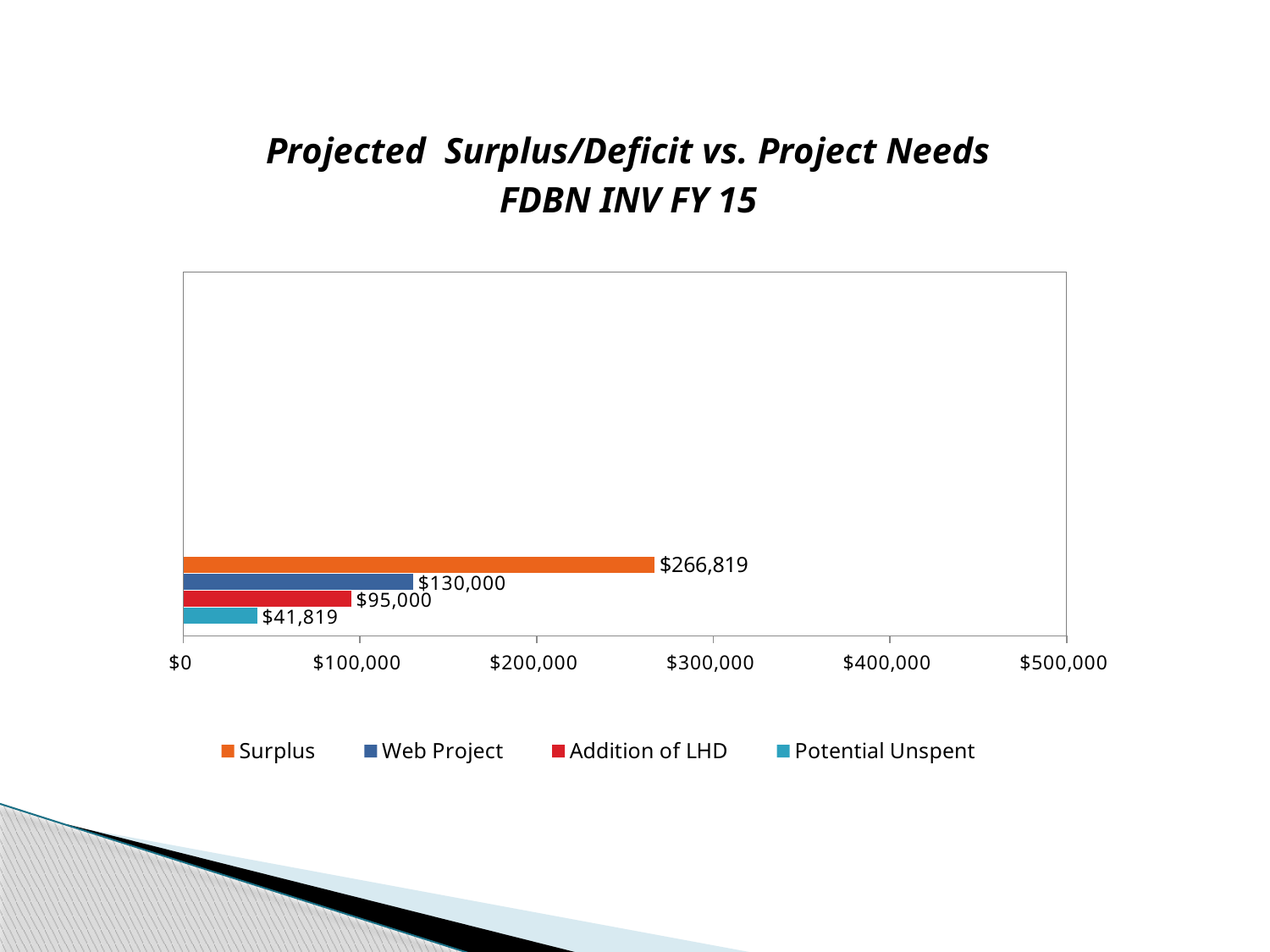
Which series has the highest value? Surplus Which series has the lowest value? Potential Unspent What is the title of the chart? Projected Surplus/Deficit vs. Project Needs FDBN INV FY 15 What is the value of the Potential Unspent bar? $41,819 What is the difference between the Web Project value and the Addition of LHD value? $35,000 What is the value of the Surplus bar? $266,819 Which is larger, Addition of LHD or Potential Unspent? Addition of LHD How many series does the legend list? 4 What is the value of the Addition of LHD bar? $95,000 What kind of chart is shown on the slide? Bar chart What is the value of the Web Project bar? $130,000 What is the difference between the Surplus value and the Web Project value? $136,819